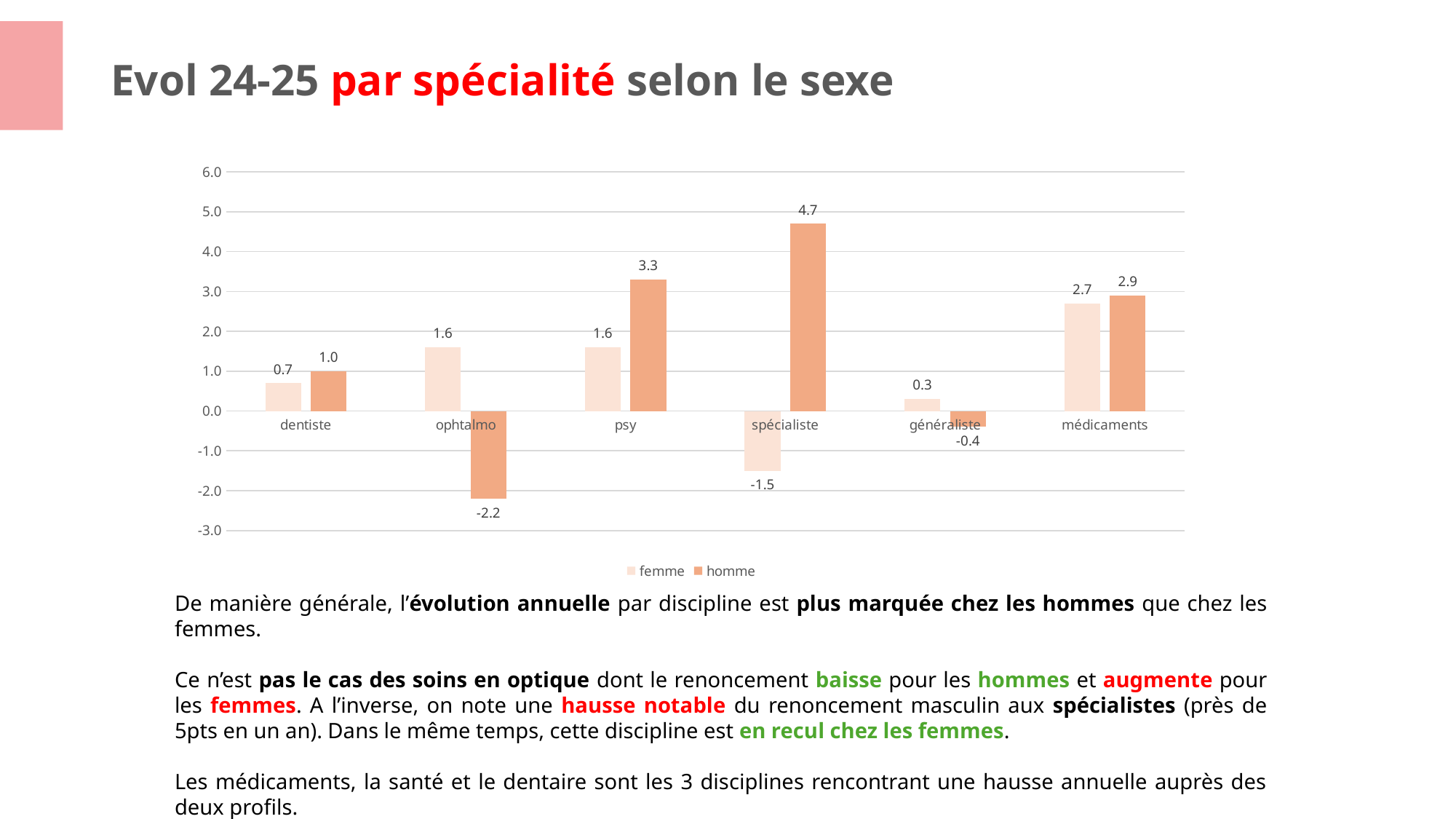
What is the value for homme in the généraliste category? -0.4 What are the two series named in the legend? femme and homme In the ophtalmo category, which series has the larger value, femme or homme? femme What kind of chart is shown on the slide? bar chart What is the difference between the homme and femme values for psy? 1.7 What is the value for femme in the médicaments category? 2.7 How many categories are shown on the x axis? 6 What is the value for homme in the spécialiste category? 4.7 Which category has the lowest value for the femme series? spécialiste What is the value for femme in the ophtalmo category? 1.6 Which category has the highest value for the homme series? spécialiste How many series does the legend list? 2